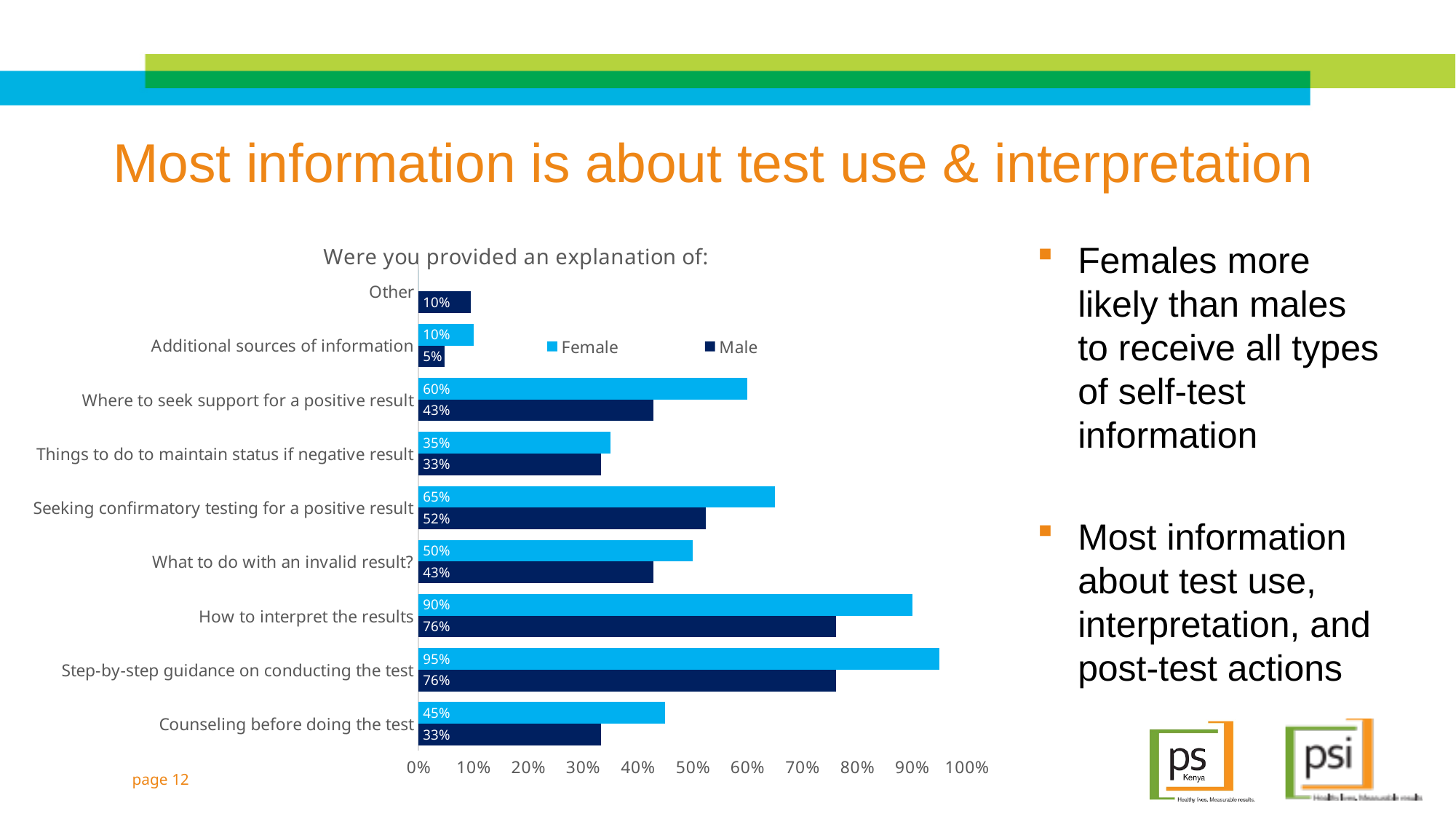
What is the Female value for "Step-by-step guidance on conducting the test"? 95% What is the Female value for "Counseling before doing the test"? 45% What is the difference between the Female and Male values for "Where to seek support for a positive result"? 17% Which category has the highest Female value? Step-by-step guidance on conducting the test What kind of chart is shown on the slide? Bar chart What is the Male value for "Seeking confirmatory testing for a positive result"? 52% Which is larger for "What to do with an invalid result?": the Female value or the Male value? Female How many categories are shown on the y axis of the chart? 9 Which category has the lowest Male value? Additional sources of information What is the title of the chart? Were you provided an explanation of: What is the Male value for "How to interpret the results"? 76% How many series does the chart legend list? 2